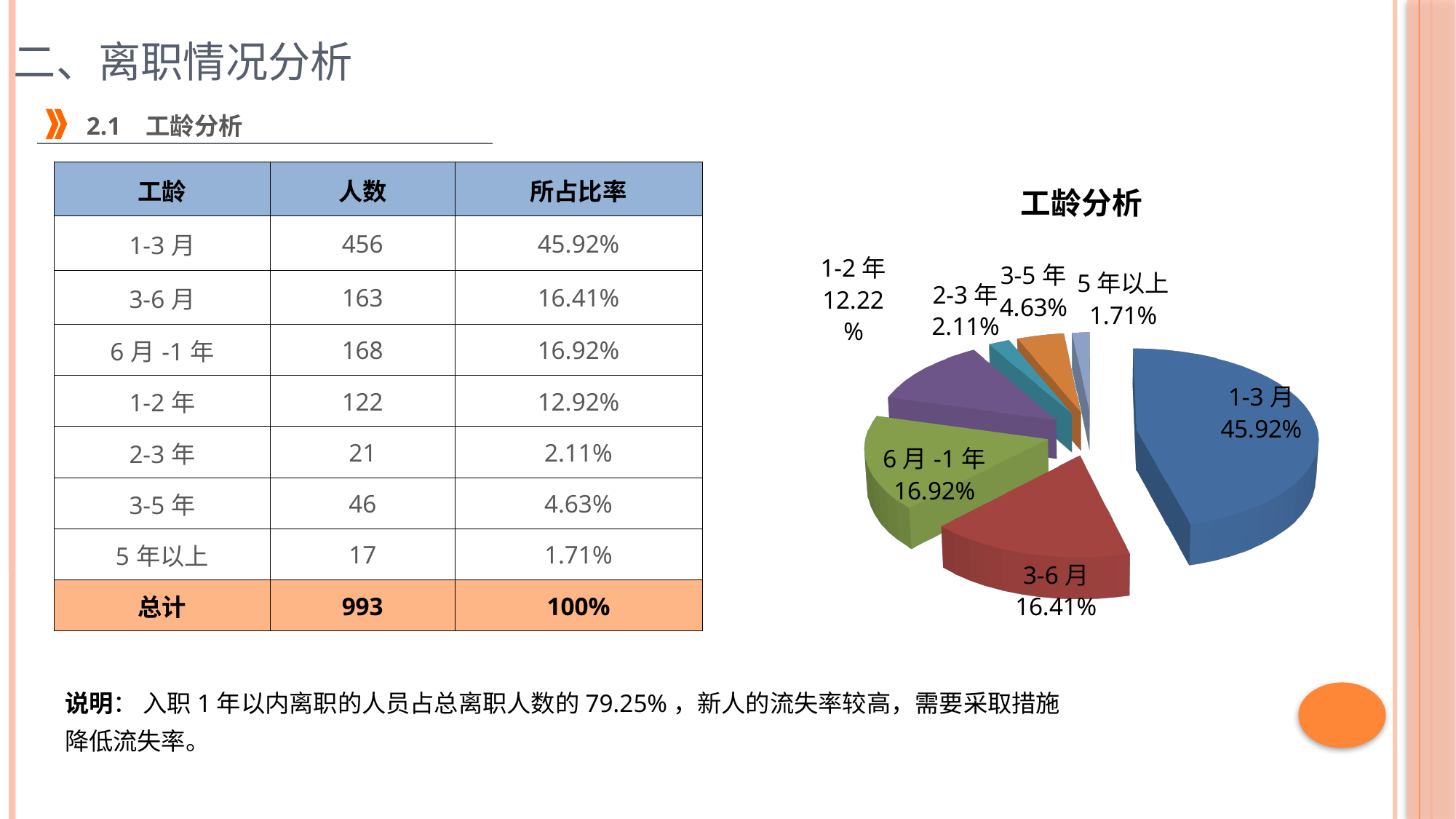
Which category has the largest slice in the pie chart? 1-3月 What percentage is shown for 5年以上 in the pie chart? 1.71% What percentage is shown for 3-5年 in the pie chart? 4.63% What share of the pie chart does 1-3月 account for? 45.92% In the pie chart, which is larger: the share for 6月-1年 or the share for 3-6月? 6月-1年 Which category has the smallest slice in the pie chart? 5年以上 How many slices does the pie chart have? 7 What kind of chart is shown on the slide? pie chart What percentage is shown for 3-6月 in the pie chart? 16.41% What percentage is shown for 6月-1年 in the pie chart? 16.92% In the pie chart, how much larger is the share for 1-3月 than the share for 3-6月? 29.51% What is the title of the pie chart? 工龄分析